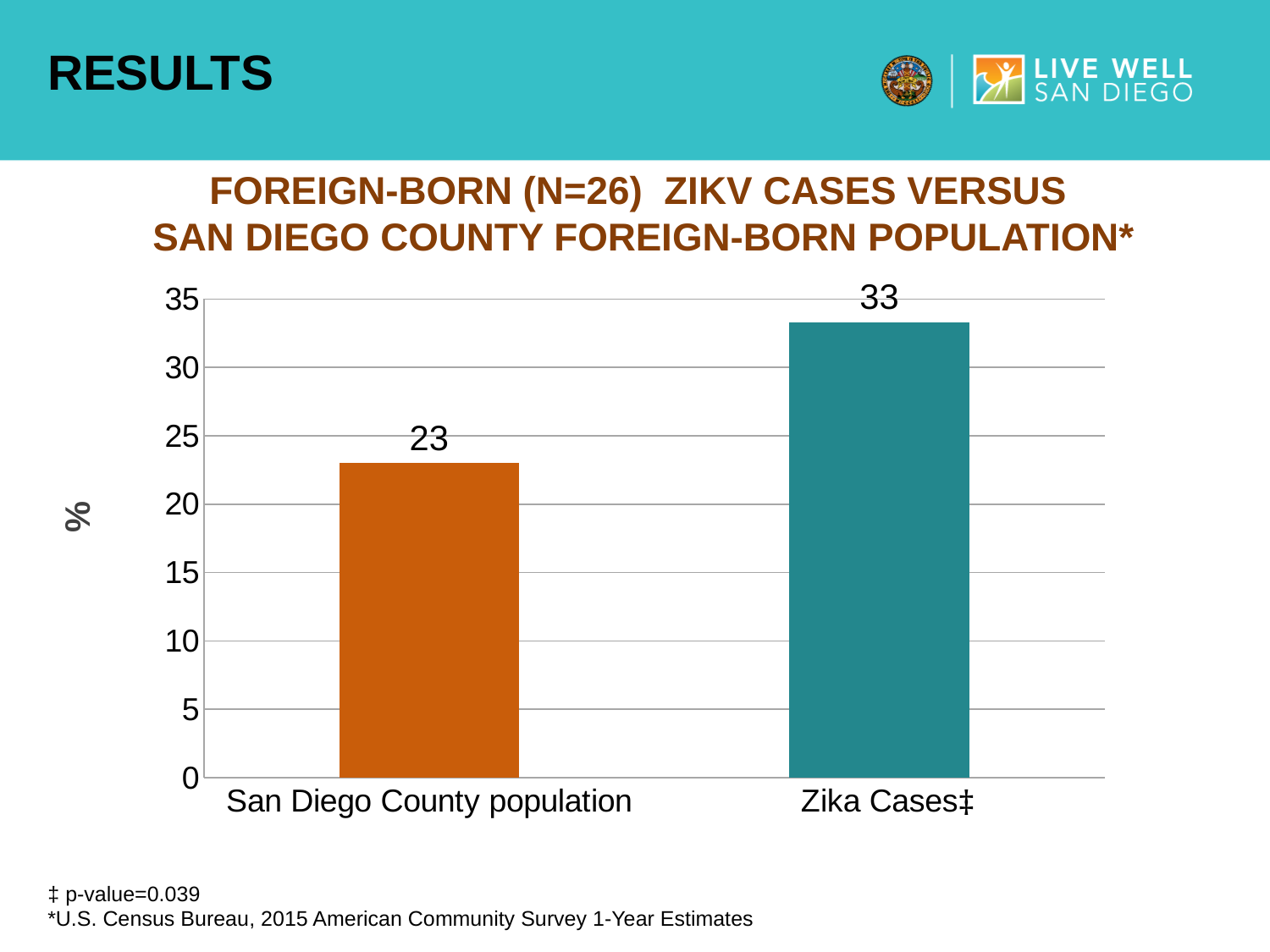
Is the value for Zika Cases‡ greater or less than 30? greater Which category has the lowest value? San Diego County population Which category has the highest value? Zika Cases‡ What is the value for San Diego County population? 23 What kind of chart is shown on the slide? Bar chart What colour is the bar for Zika Cases‡? Teal What is the value for Zika Cases‡? 33 What is the difference between the values for Zika Cases‡ and San Diego County population? 10 How many categories are shown on the x axis? 2 Which is larger, the value for San Diego County population or the value for Zika Cases‡? Zika Cases‡ What is the label on the y axis? % Is the value for San Diego County population greater or less than 25? less